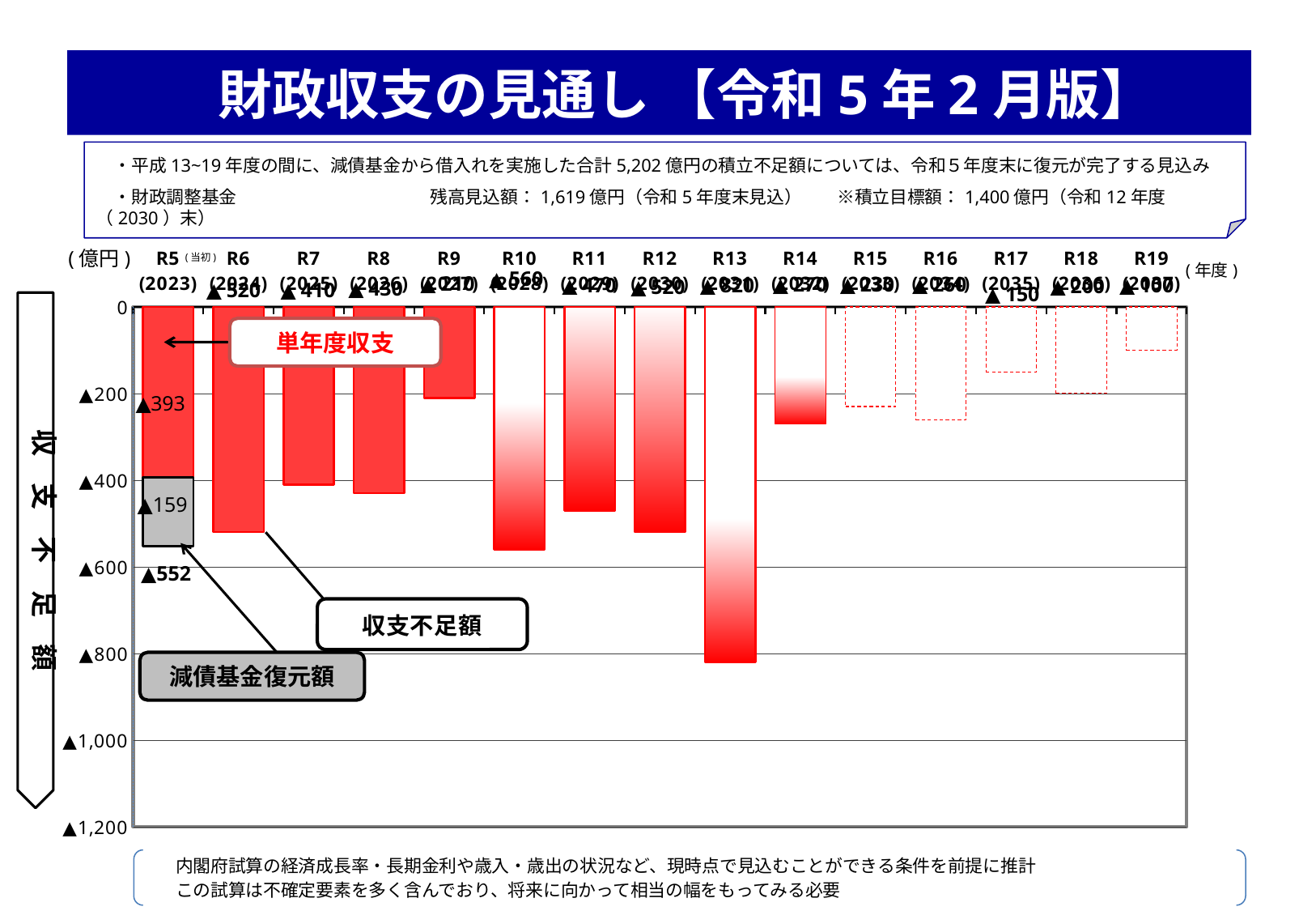
Which fiscal year has the largest 収支不足額 (longest bar)? R13 (2031) What kind of chart is shown on the slide? bar chart What is the 減債基金復元額 value shown for R5 (2023)? ▲159 What is the 単年度収支 value shown for R5 (2023)? ▲393 How many fiscal years are shown on the x axis of the chart? 15 What is the title of the slide containing the chart? 財政収支の見通し【令和5年2月版】 Is the shortfall for R6 (2024) greater or less than 400? greater What is the total 収支不足額 shown for R5 (2023)? ▲552 What value is shown for R17 (2035)? ▲150 Which has the larger shortfall, R10 (2028) or R11 (2029)? R10 (2028)